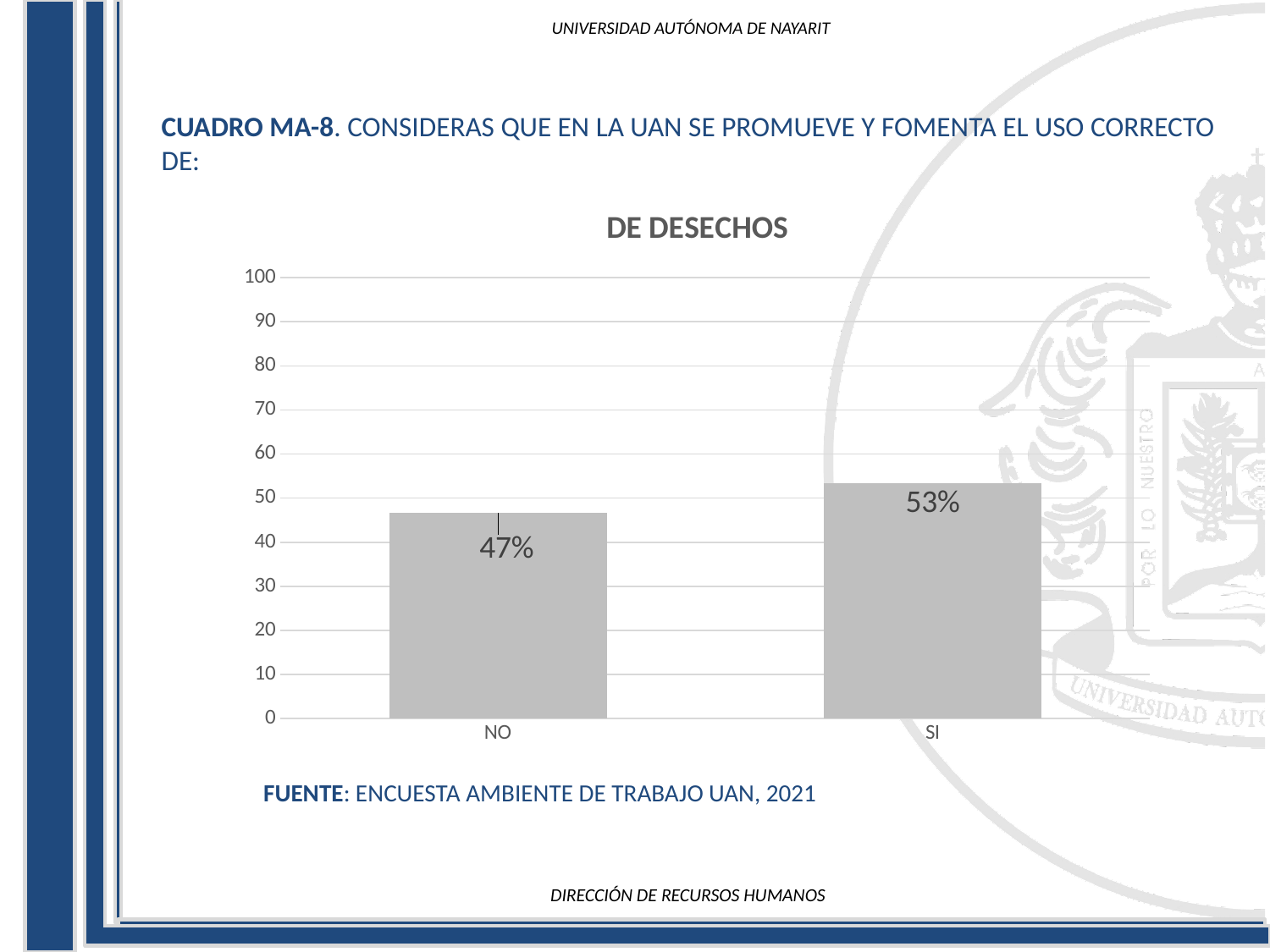
What is the title of the chart? DE DESECHOS Which category has the lowest value? NO Which category has the highest value? SI Which is larger, the value for NO or the value for SI? SI How many categories are shown on the x axis? 2 Is the value for NO greater or less than 50? less What is the highest value shown on the y axis? 100 What is the difference between the values for SI and NO? 6% What is the value for SI? 53% Is the value for SI greater or less than 50? greater What kind of chart is shown? bar chart What is the value for NO? 47%